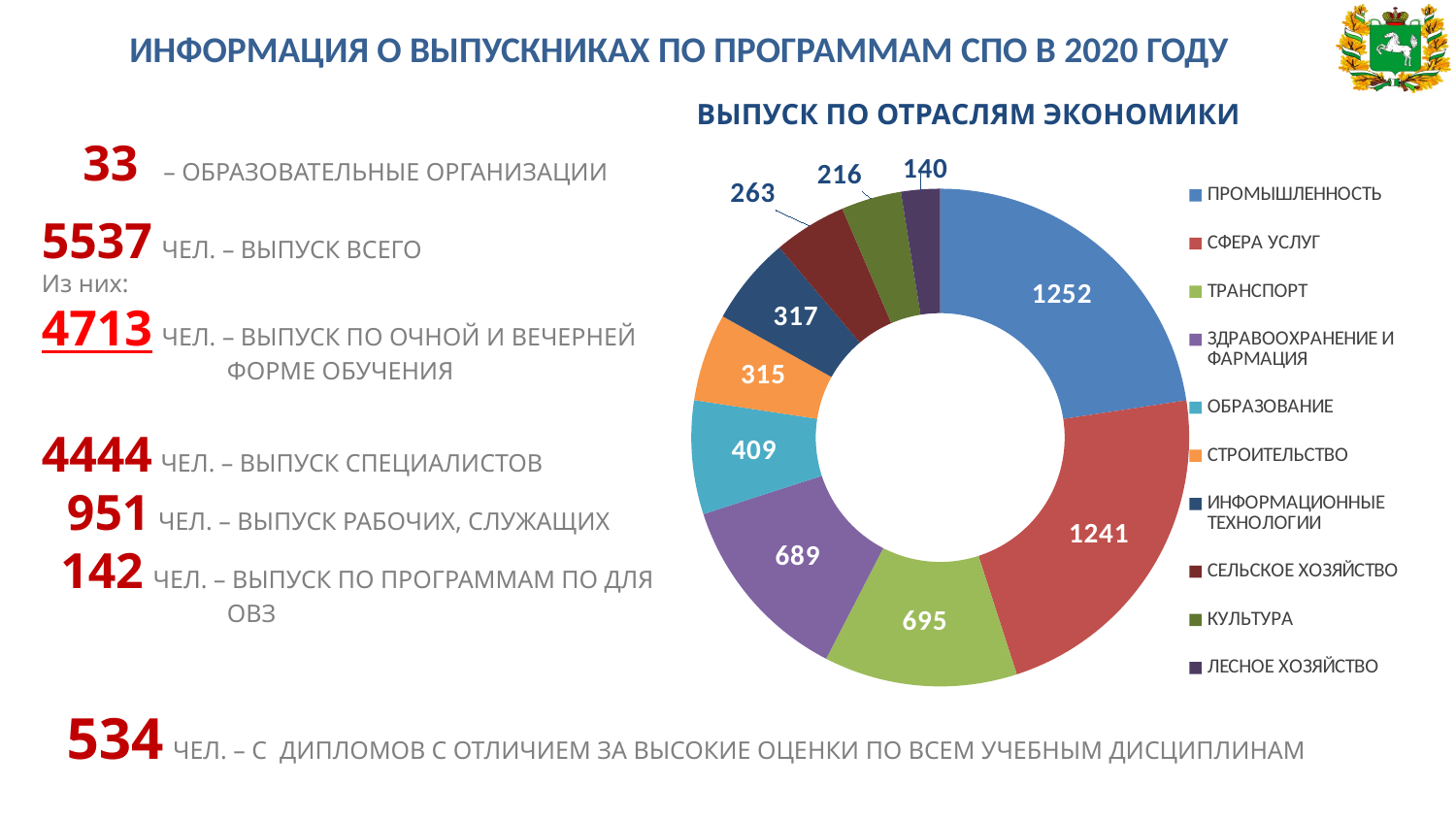
Which sector has the smallest value in the chart? ЛЕСНОЕ ХОЗЯЙСТВО What is the value for СЕЛЬСКОЕ ХОЗЯЙСТВО in the chart? 263 What colour is the ПРОМЫШЛЕННОСТЬ slice in the chart? blue What is the value for ПРОМЫШЛЕННОСТЬ in the chart? 1252 Which is larger: the value for ТРАНСПОРТ or the value for ОБРАЗОВАНИЕ? ТРАНСПОРТ How many sectors are shown in the chart? 10 What type of chart is shown under the title "ВЫПУСК ПО ОТРАСЛЯМ ЭКОНОМИКИ"? doughnut (pie) chart What is the total of all the values shown in the chart? 5537 What is the difference between the values for ПРОМЫШЛЕННОСТЬ and СФЕРА УСЛУГ? 11 What is the difference between the values for ОБРАЗОВАНИЕ and СТРОИТЕЛЬСТВО? 94 What is the value for ЗДРАВООХРАНЕНИЕ И ФАРМАЦИЯ in the chart? 689 Which sector has the largest value in the chart? ПРОМЫШЛЕННОСТЬ